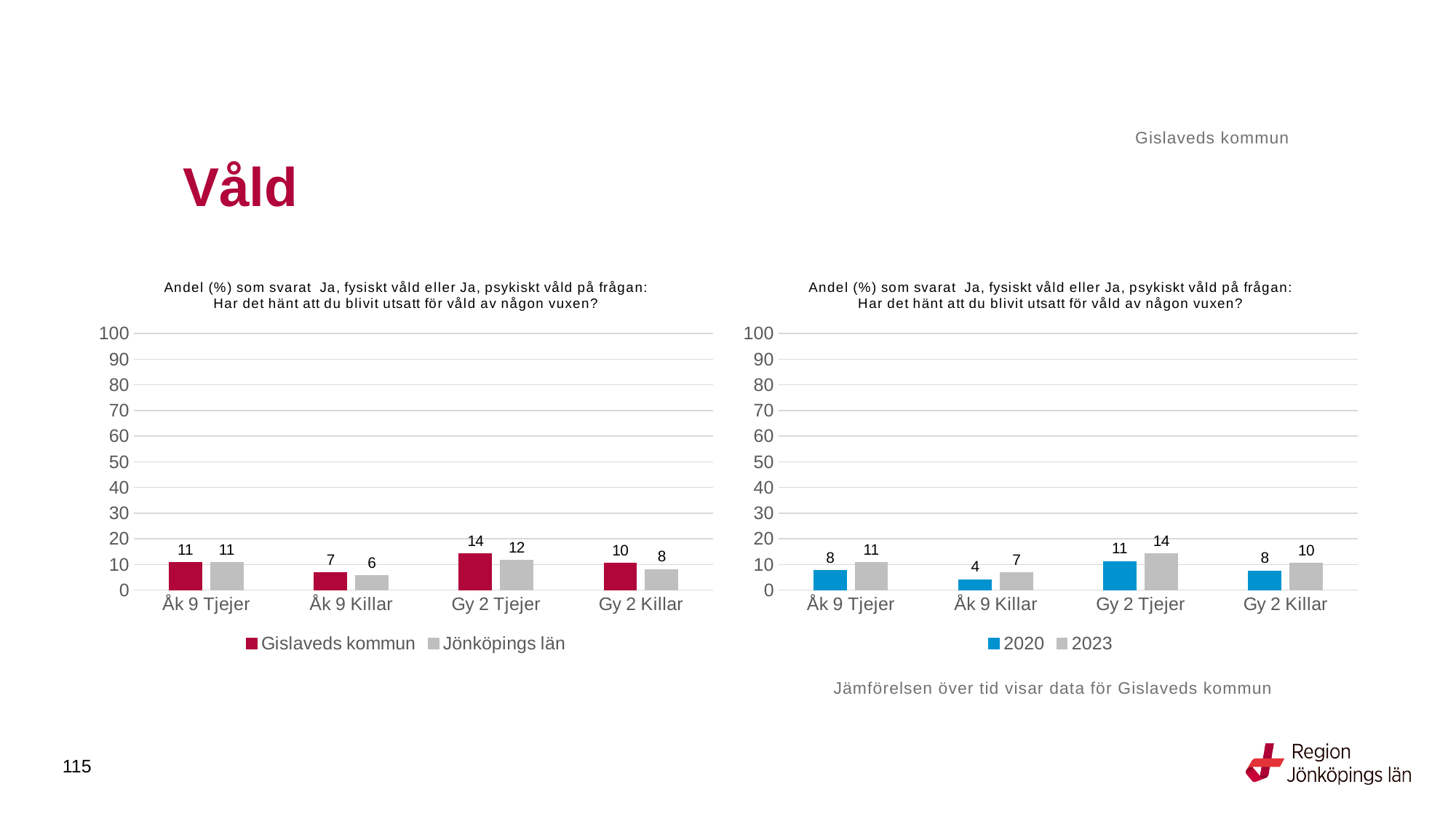
What kind of chart is the left chart? Bar chart In the left chart, what is the difference between Gislaveds kommun and Jönköpings län for Gy 2 Killar? 2 In the right chart, which category has the lowest 2020 value? Åk 9 Killar In the right chart, what is the difference between the 2023 and 2020 values for Gy 2 Tjejer? 3 In the left chart, which category has the highest value for Gislaveds kommun? Gy 2 Tjejer In the left chart, what is the value for Gislaveds kommun for Gy 2 Tjejer? 14 In the right chart, what is the 2020 value for Åk 9 Killar? 4 How many series does the legend of the right chart list? 2 In the left chart, what is the value for Jönköpings län for Åk 9 Killar? 6 How many categories are shown on the x axis of the left chart? 4 In the right chart, what is the 2023 value for Gy 2 Killar? 10 In the right chart, which is larger for Åk 9 Tjejer: the 2020 value or the 2023 value? 2023